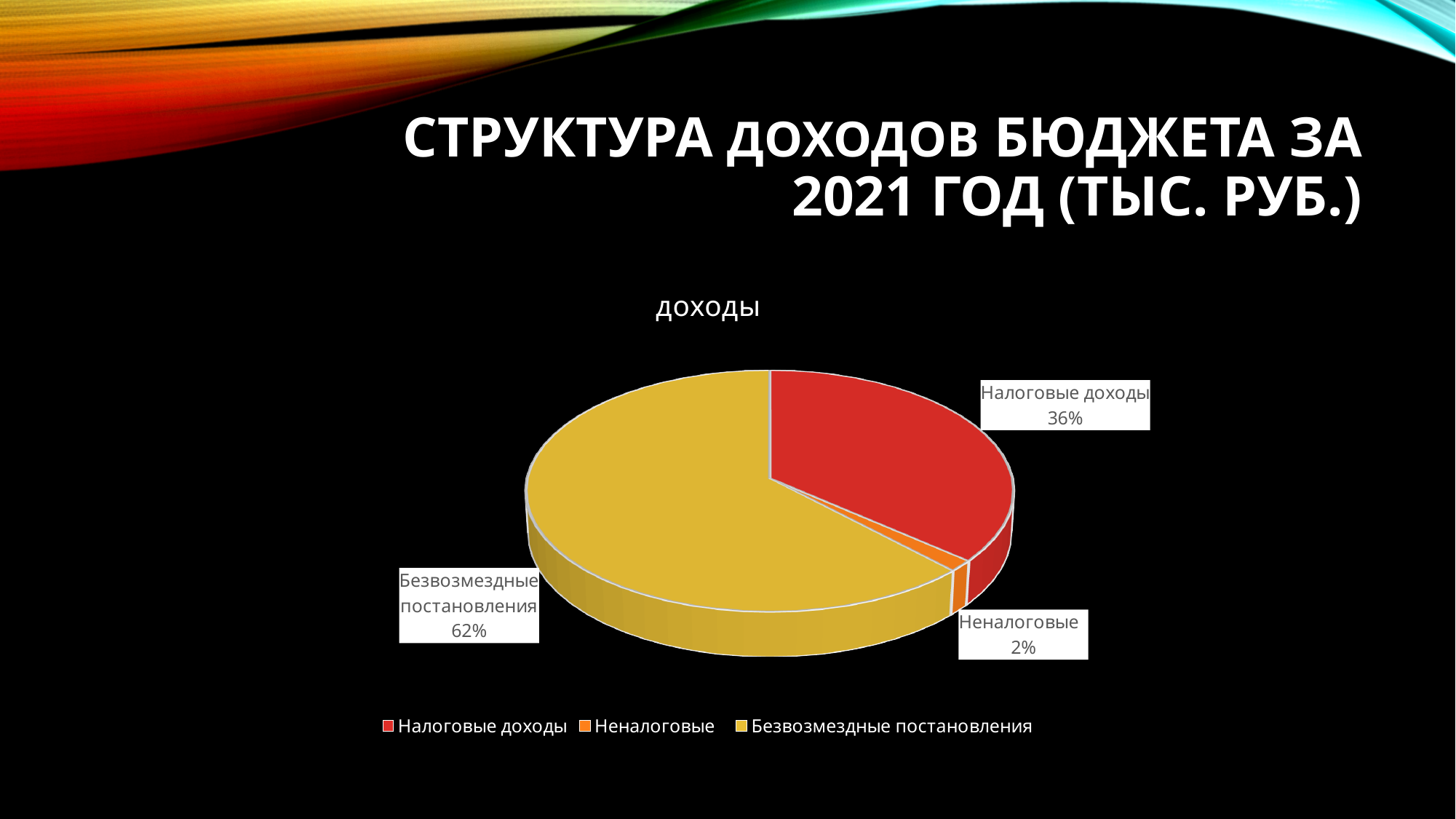
What is the difference in percentage points between Безвозмездные постановления and Налоговые доходы? 26 How many slices does the pie chart have? 3 What colour is the slice for Безвозмездные постановления? Yellow What share of the pie does Безвозмездные постановления represent? 62% What share of the pie does Налоговые доходы represent? 36% Which category has the smallest slice of the pie? Неналоговые What is the title of the chart? доходы Which is larger: the share for Налоговые доходы or the share for Неналоговые? Налоговые доходы What share of the pie does Неналоговые represent? 2% What kind of chart is shown on the slide? Pie chart What is the difference in percentage points between Налоговые доходы and Неналоговые? 34 Which category has the largest slice of the pie? Безвозмездные постановления